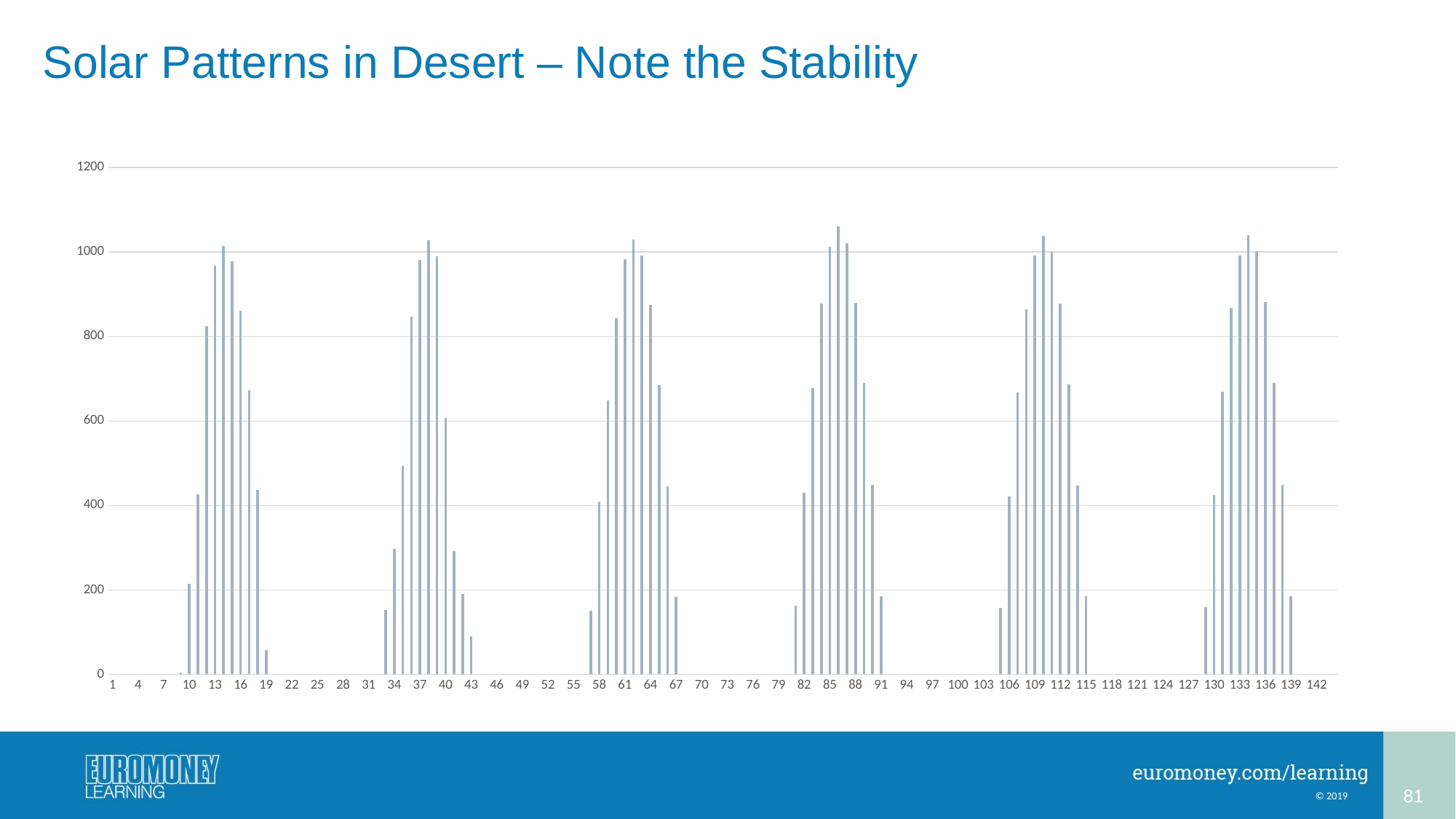
Is the value for category 19 greater or less than 200? less Is the value for category 86 greater or less than 1000? greater What is the highest value labelled on the vertical axis of the chart? 1200 Is the value for category 43 greater or less than 200? less What is the title of the slide containing the chart? Solar Patterns in Desert – Note the Stability How many separate clusters of bars (peaks) appear across the chart? 6 What kind of chart is shown on the slide? bar chart